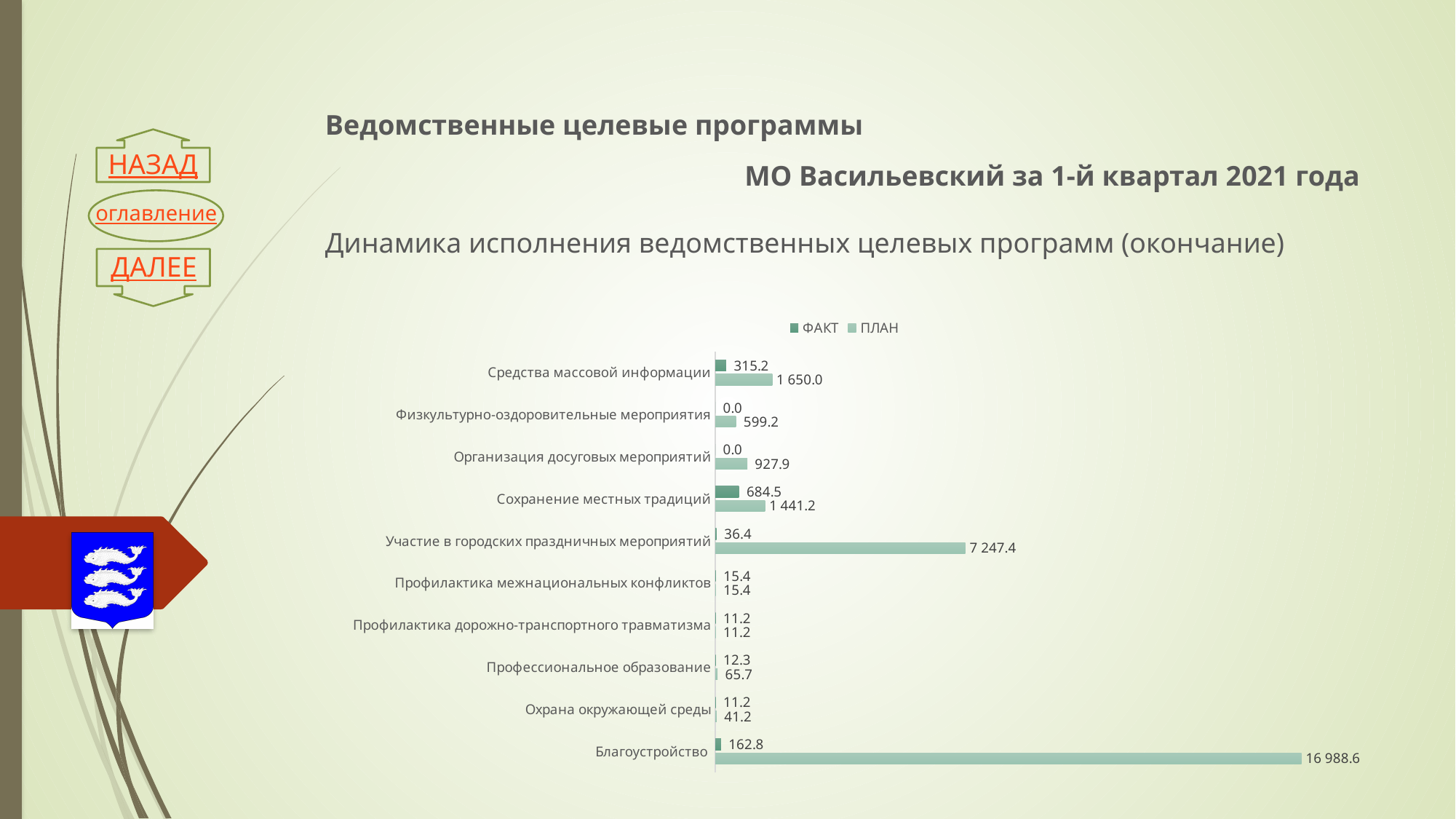
How many categories are shown on the chart? 10 Which is larger for Профессиональное образование, the ФАКТ value or the ПЛАН value? ПЛАН Which category has the highest ПЛАН value? Благоустройство What is the ФАКТ value for Сохранение местных традиций? 684.5 What is the ПЛАН value for Благоустройство? 16 988.6 What kind of chart is shown on the slide? Bar chart Which category has the highest ФАКТ value? Сохранение местных традиций What is the difference between the ПЛАН and ФАКТ values for Средства массовой информации? 1 334.8 What are the two series named in the legend? ФАКТ and ПЛАН How many series does the legend list? 2 What is the ФАКТ value for Средства массовой информации? 315.2 What is the ПЛАН value for Участие в городских праздничных мероприятиях? 7 247.4